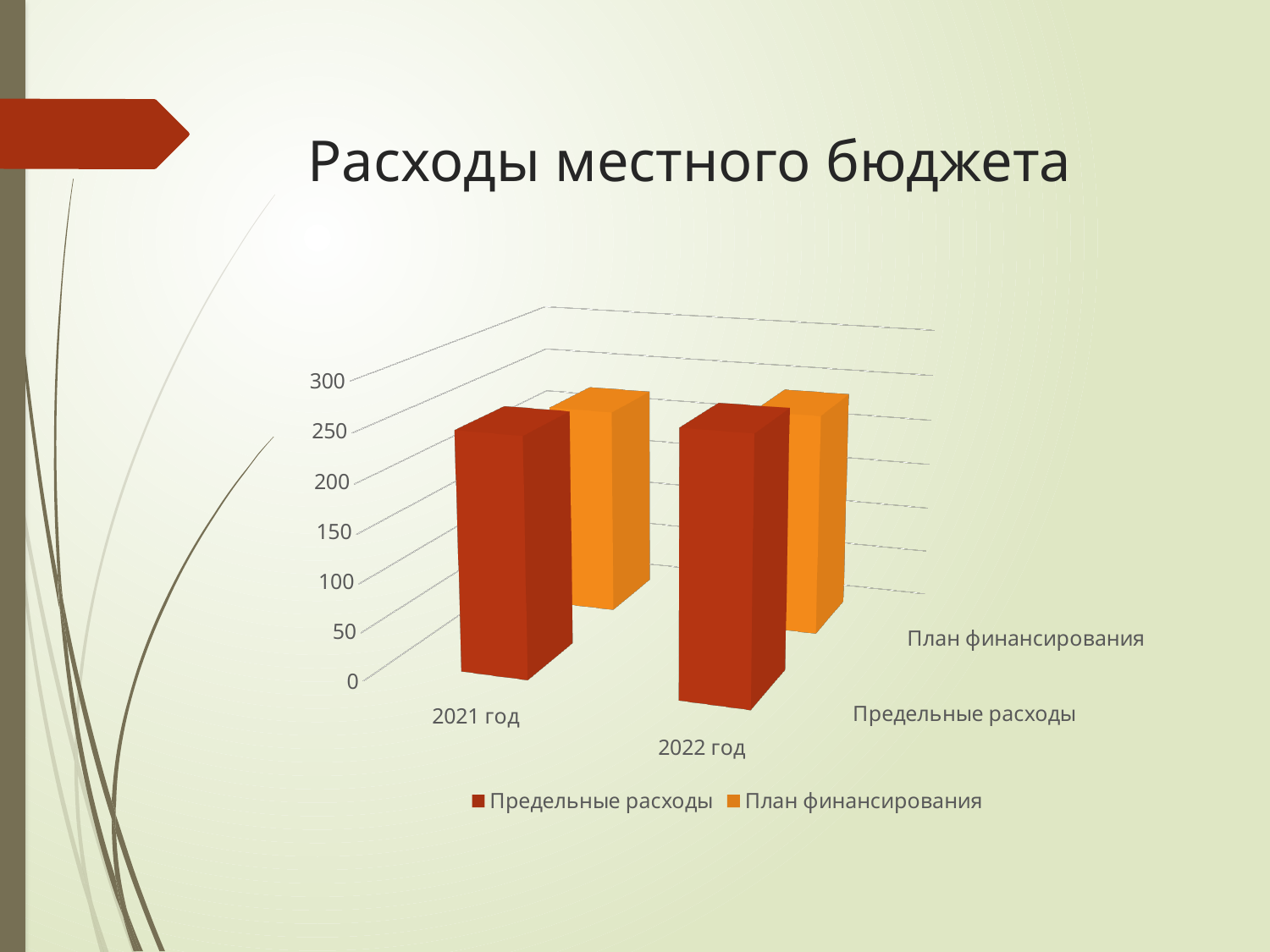
What is the title of the chart? Расходы местного бюджета Is the value for План финансирования in 2022 год greater or less than 300? less Is the value for Предельные расходы in 2021 год greater or less than 100? greater Is the value for План финансирования in 2021 год greater or less than 150? greater How many series does the legend list? 2 Which series is shown in dark red? Предельные расходы How many year categories are shown on the x axis? 2 What kind of chart is shown on the slide? bar chart What is the highest value shown on the vertical axis? 300